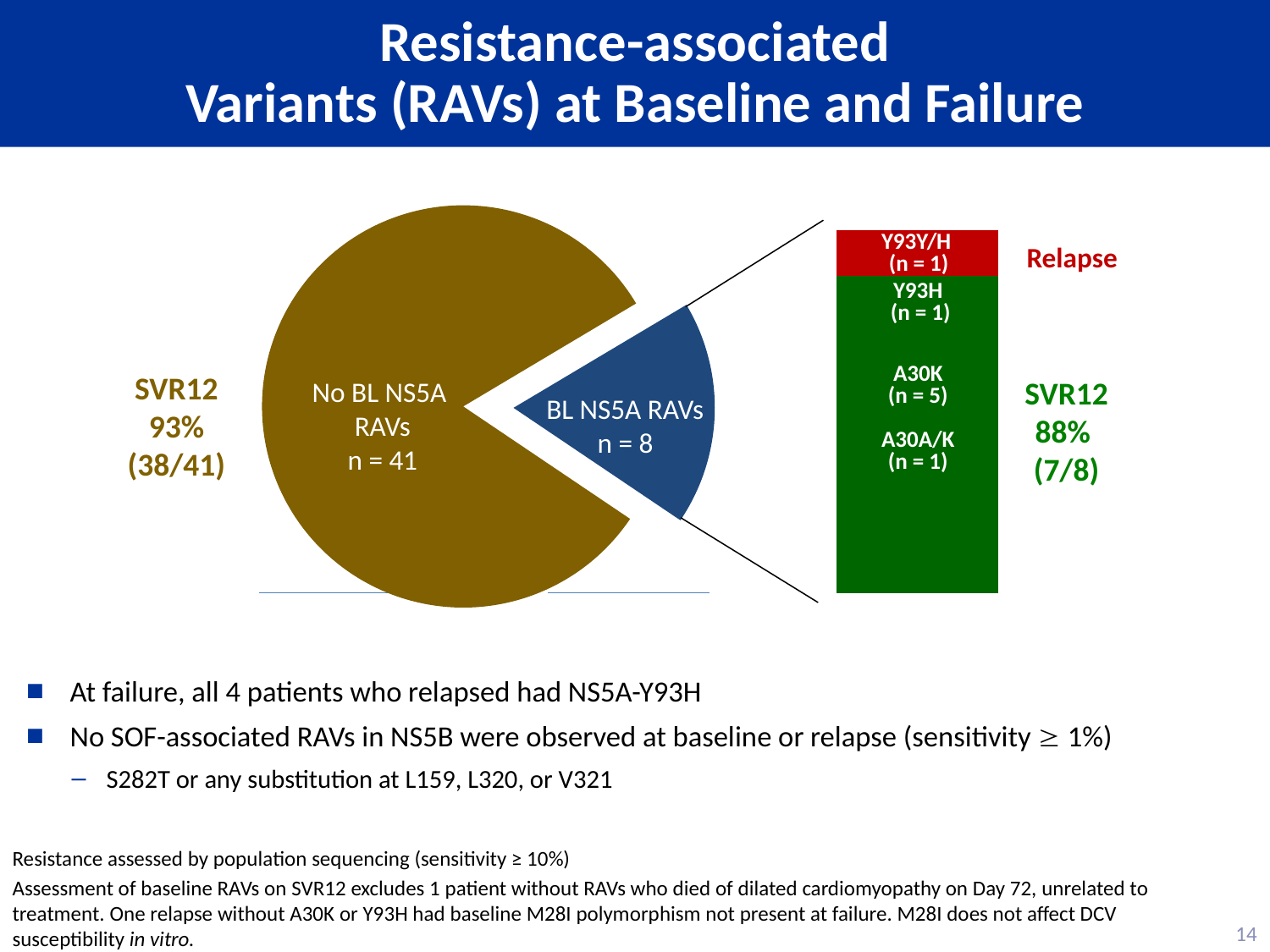
What SVR12 rate is shown for the No BL NS5A RAVs group? 93% (38/41) What is the difference in patient count between the No BL NS5A RAVs slice and the BL NS5A RAVs slice? 33 In the stacked bar breaking down the BL NS5A RAVs slice, what is the count for A30K? n = 5 Which slice of the pie chart is larger, No BL NS5A RAVs or BL NS5A RAVs? No BL NS5A RAVs How many slices does the pie chart have? 2 In the pie chart, what is the value for BL NS5A RAVs? n = 8 In the pie chart, what is the value for No BL NS5A RAVs? n = 41 What kind of chart is shown on the left of the slide? pie chart In the stacked bar breaking down the BL NS5A RAVs slice, which variant has the largest count? A30K What SVR12 rate is shown for the BL NS5A RAVs group? 88% (7/8) What is the total number of patients represented by the two pie slices? 49 In the stacked bar, which variant segment is coloured red and labelled Relapse? Y93Y/H